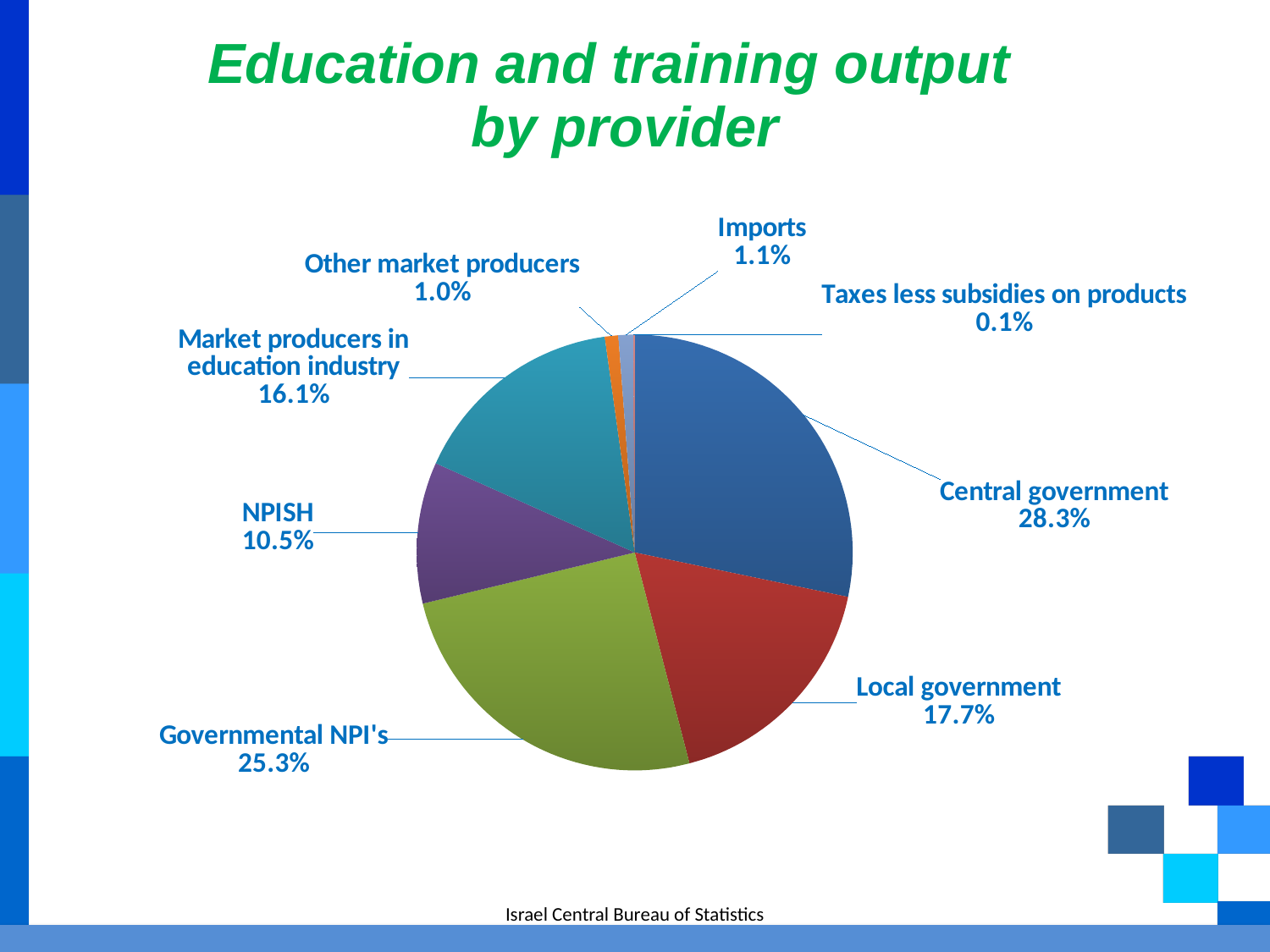
What type of chart is shown on the slide? Pie chart What share of education and training output is provided by Governmental NPI's? 25.3% What share of education and training output comes from Imports? 1.1% Which has a larger share of education and training output, NPISH or Market producers in education industry? Market producers in education industry What share of education and training output is provided by Local government? 17.7% How many categories are shown in the pie chart? 8 What share of education and training output is provided by Market producers in education industry? 16.1% What is the difference in percentage points between the Central government share and the Local government share? 10.6 What share of education and training output is provided by NPISH? 10.5% What share of education and training output is provided by Central government? 28.3% Which category has the smallest share of education and training output? Taxes less subsidies on products Which provider has the largest share of education and training output? Central government